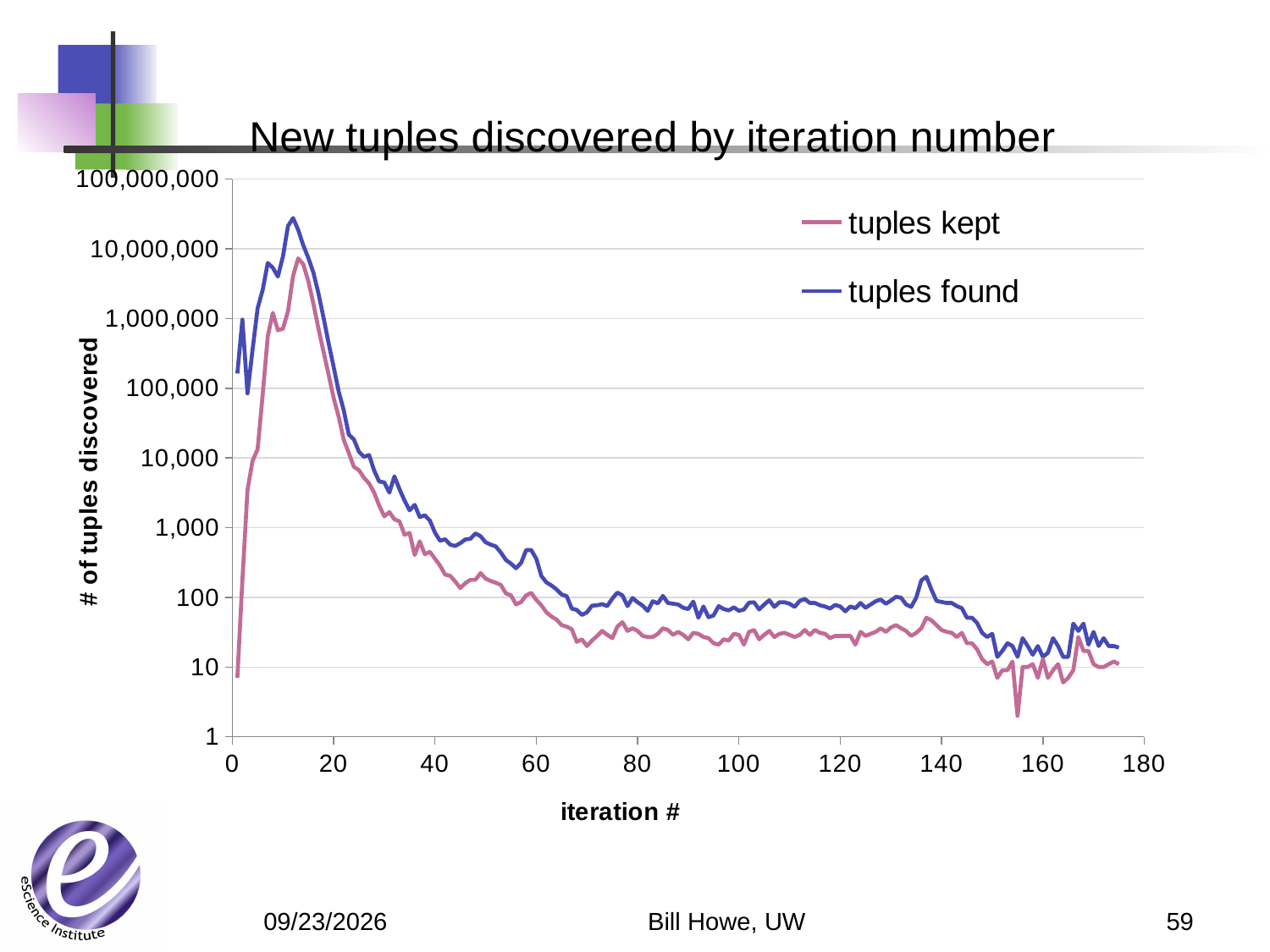
What is the label on the vertical axis? # of tuples discovered At iteration 40, which series has the larger value, tuples kept or tuples found? tuples found Is the peak value of the tuples found series greater or less than 10,000,000? greater Is the value of tuples kept at iteration 100 greater or less than 100? less Which series reaches the higher peak, tuples kept or tuples found? tuples found What is the title of the chart? New tuples discovered by iteration number How many series does the legend list? 2 Is the value of tuples found at iteration 100 greater or less than 1,000? less Between iteration 20 and iteration 60, do the values of the tuples found series rise or fall? fall What kind of chart is shown on the slide? line chart